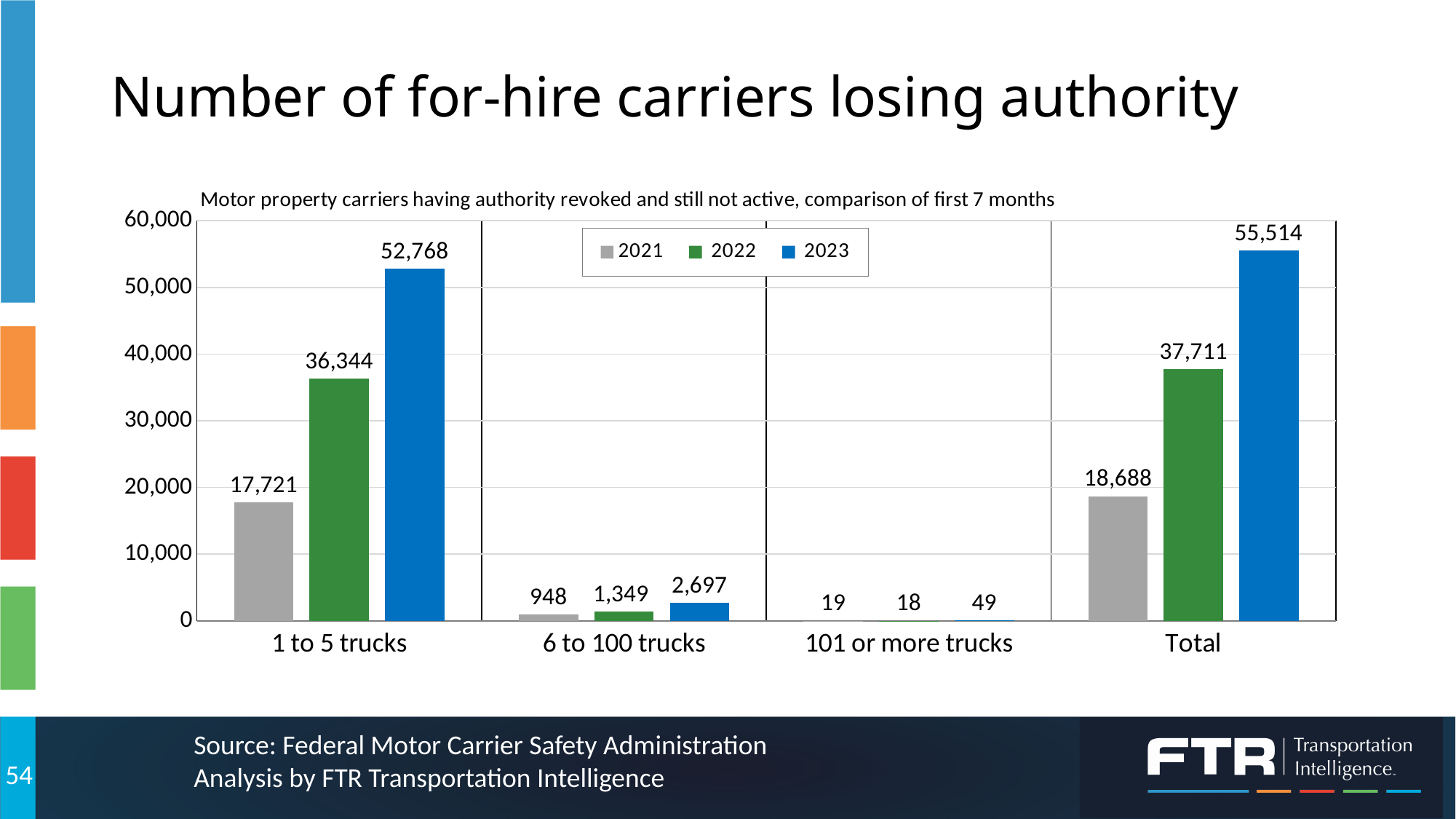
What is the value for 2023 in the '1 to 5 trucks' category? 52,768 What is the value for 2021 in the 'Total' category? 18,688 How many series does the legend list? 3 Which is larger in the '1 to 5 trucks' category: the 2021 value or the 2022 value? 2022 How many categories are shown on the x axis? 4 What is the difference between the 2023 and 2022 values in the 'Total' category? 17,803 Which category has the lowest value for 2021? 101 or more trucks Is the 2022 value for 'Total' greater or less than 40,000? less What kind of chart is shown on the slide? bar chart What is the value for 2022 in the '6 to 100 trucks' category? 1,349 Which category has the highest value for 2023? Total What is the value for 2023 in the '101 or more trucks' category? 49